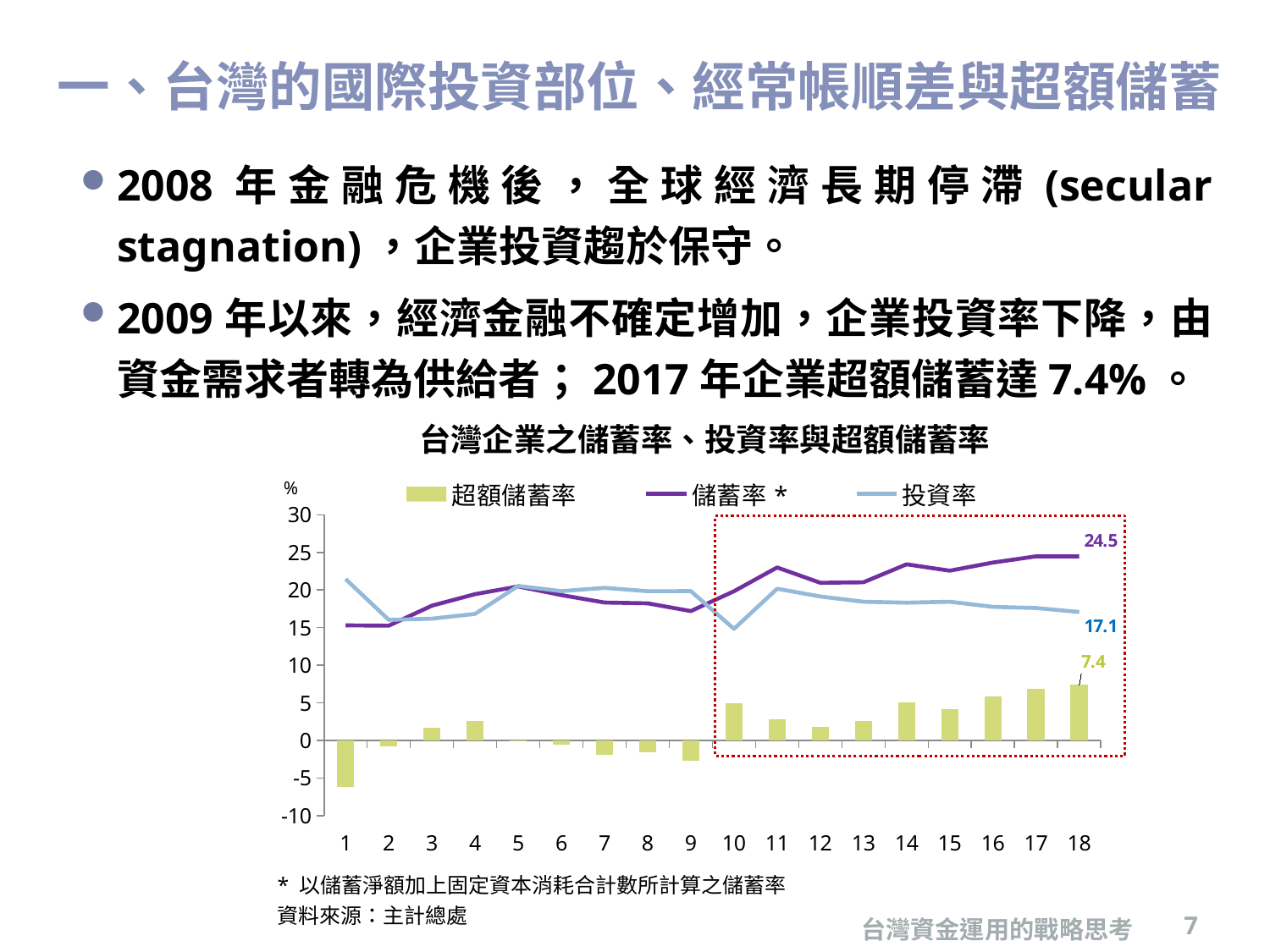
At point 18, which is larger, 儲蓄率 or 投資率? 儲蓄率 What kind of chart is this? Combined bar and line chart Is the value for 超額儲蓄率 at point 1 greater or less than 0? less What is the title of the chart? 台灣企業之儲蓄率、投資率與超額儲蓄率 What is the value of 超額儲蓄率 at point 18? 7.4 How many points are shown along the x axis? 18 What is the value of 儲蓄率 at point 18? 24.5 At point 18, what is the difference between 儲蓄率 and 投資率? 7.4 How many series does the legend list? 3 What is the value of 投資率 at point 18? 17.1 At which point is 超額儲蓄率 highest? 18 Is the value for 投資率 at point 1 greater or less than 20? greater